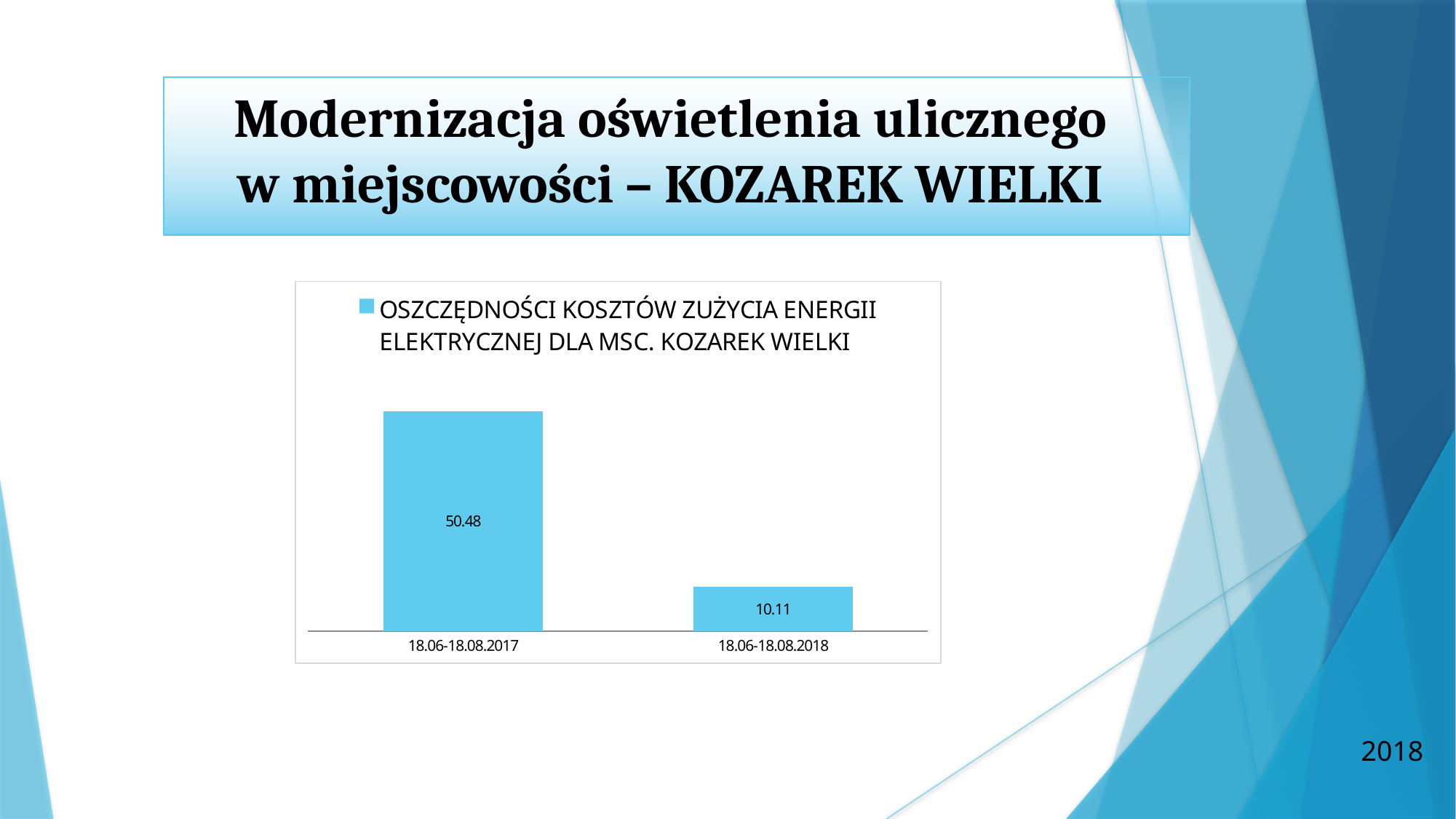
What is the legend entry of the series shown in the chart? OSZCZĘDNOŚCI KOSZTÓW ZUŻYCIA ENERGII ELEKTRYCZNEJ DLA MSC. KOZAREK WIELKI What kind of chart is shown on the slide? bar chart How many categories are shown on the x axis? 2 What is the value for 18.06-18.08.2017? 50.48 What is the difference between the values for 18.06-18.08.2017 and 18.06-18.08.2018? 40.37 Do the values rise or fall from 18.06-18.08.2017 to 18.06-18.08.2018? fall Which category has the highest value? 18.06-18.08.2017 What colour are the bars in the chart? light blue What is the value for 18.06-18.08.2018? 10.11 Which is larger, the value for 18.06-18.08.2017 or for 18.06-18.08.2018? 18.06-18.08.2017 How many series does the legend list? 1 Which category has the lowest value? 18.06-18.08.2018